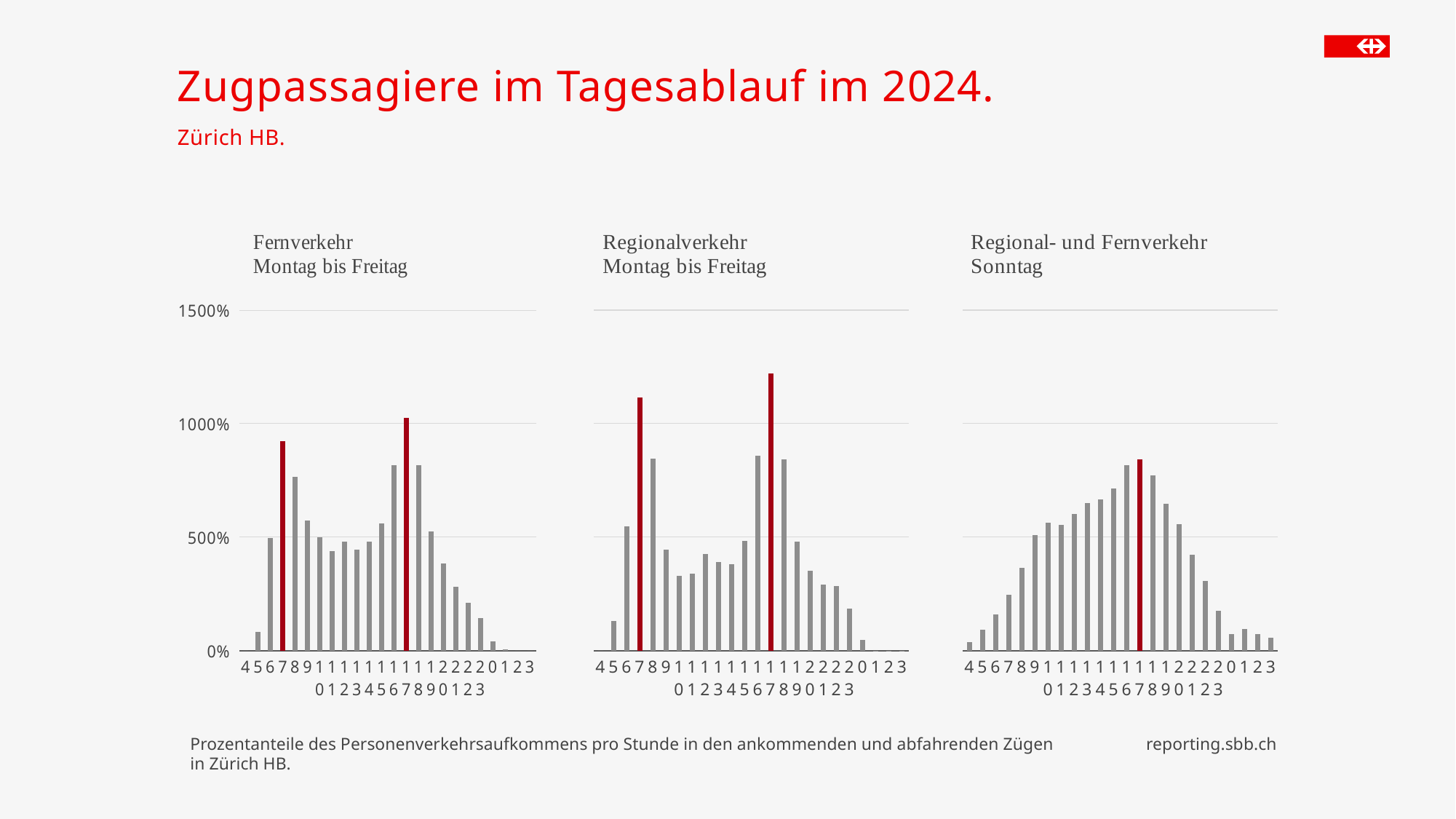
How many bar charts are shown on the slide? 3 What kind of chart is the 'Fernverkehr Montag bis Freitag' chart? bar chart How many hourly categories does the 'Regionalverkehr Montag bis Freitag' chart show on its x axis? 24 In the 'Fernverkehr Montag bis Freitag' chart, which is larger, the value for hour 8 or the value for hour 9? hour 8 In the 'Regionalverkehr Montag bis Freitag' chart, is the value for hour 17 greater or less than 1000%? greater In the 'Regionalverkehr Montag bis Freitag' chart, which is larger, the value for hour 7 or the value for hour 8? hour 7 In the 'Fernverkehr Montag bis Freitag' chart, which hour has the highest value? 17 In the 'Regional- und Fernverkehr Sonntag' chart, is the value for hour 4 greater or less than 500%? less In the 'Fernverkehr Montag bis Freitag' chart, is the value for hour 7 greater or less than 500%? greater What is the title of the slide? Zugpassagiere im Tagesablauf im 2024. In the 'Regionalverkehr Montag bis Freitag' chart, which hour has the highest value? 17